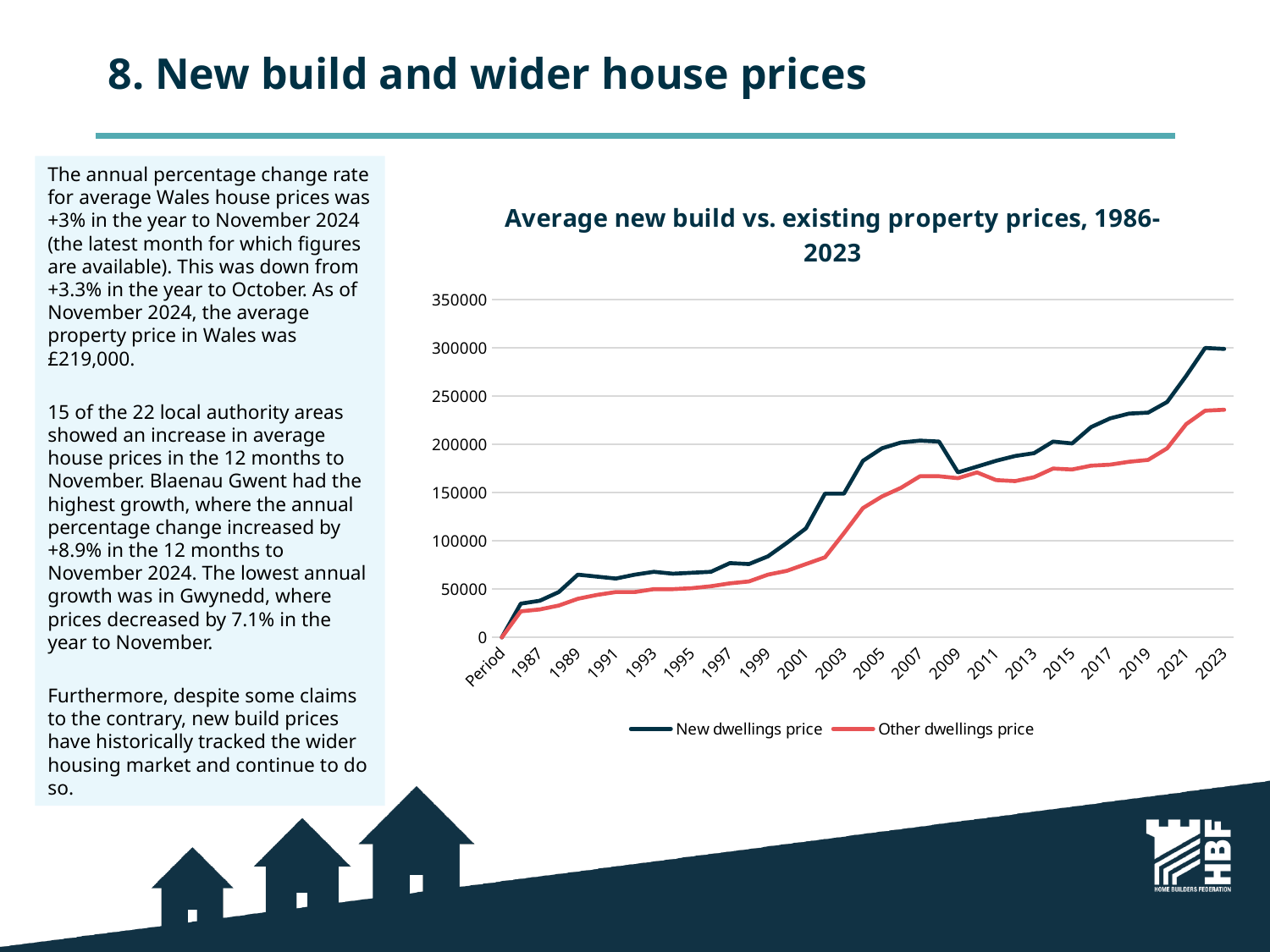
Is the New dwellings price in 2009 greater or less than 200000? less In 2023, which series has the higher value, New dwellings price or Other dwellings price? New dwellings price How many series does the chart's legend list? 2 Is the Other dwellings price in 2003 greater or less than 100000? greater Is the New dwellings price in 2021 greater or less than 200000? greater What is the title of the chart? Average new build vs. existing property prices, 1986-2023 Which series is drawn in red on the chart? Other dwellings price What kind of chart is shown on the slide? Line chart Overall, do the New dwellings price values rise or fall from left to right along the x axis? Rise In 2003, which series has the higher value, New dwellings price or Other dwellings price? New dwellings price